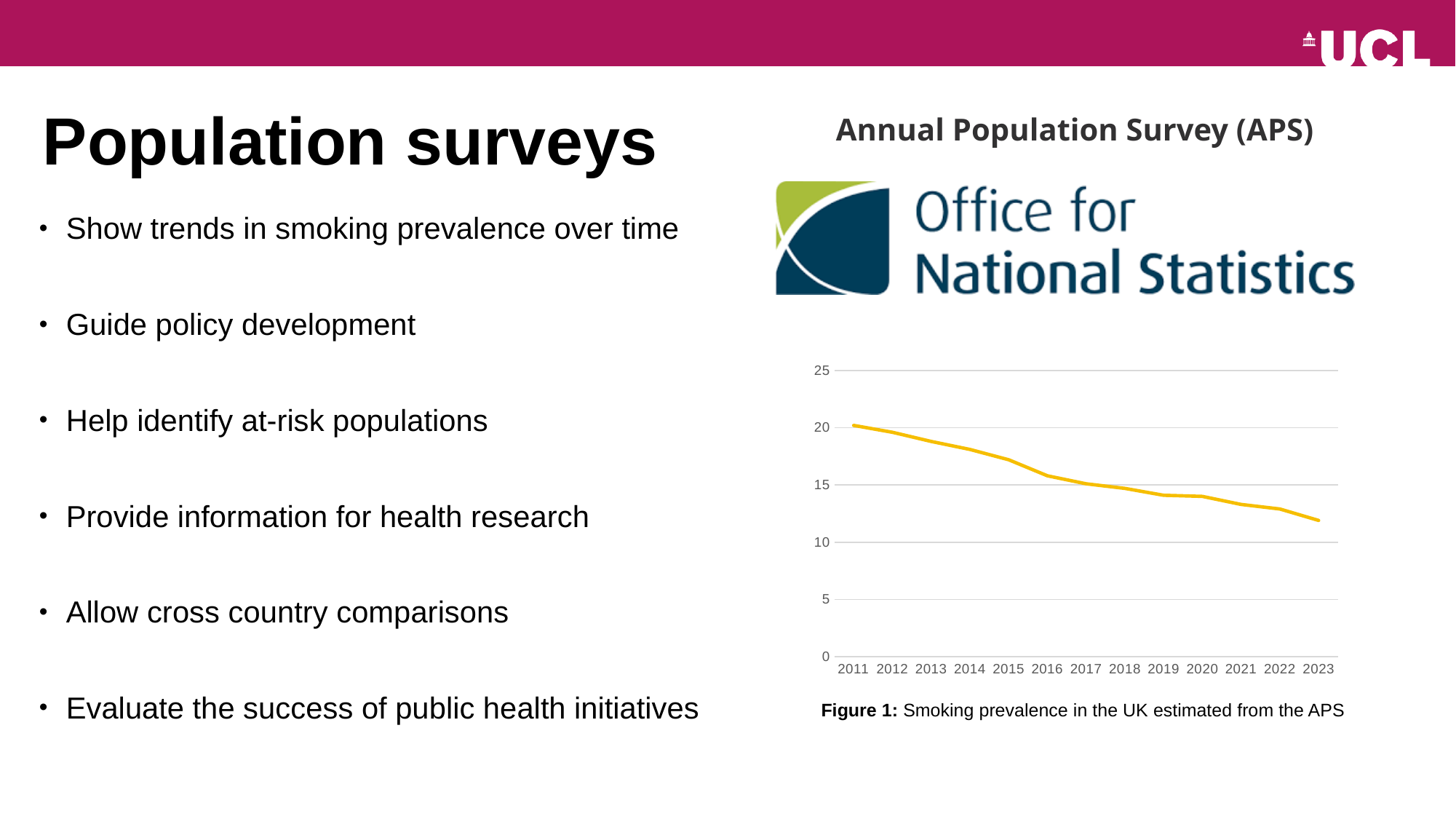
Is the value for 2020 greater or less than 15? less Which year has the larger value, 2013 or 2020? 2013 Which year has the highest smoking prevalence in the chart? 2011 Do the values in the chart rise or fall from 2011 to 2023? Fall Is the value for 2023 greater or less than 15? less What is the caption given for the chart (Figure 1)? Smoking prevalence in the UK estimated from the APS What kind of chart is shown on the slide? Line chart How many years are plotted along the x axis of the chart? 13 Which year has the larger value, 2011 or 2023? 2011 Which year has the lowest smoking prevalence in the chart? 2023 Is the value for 2023 greater or less than 10? greater